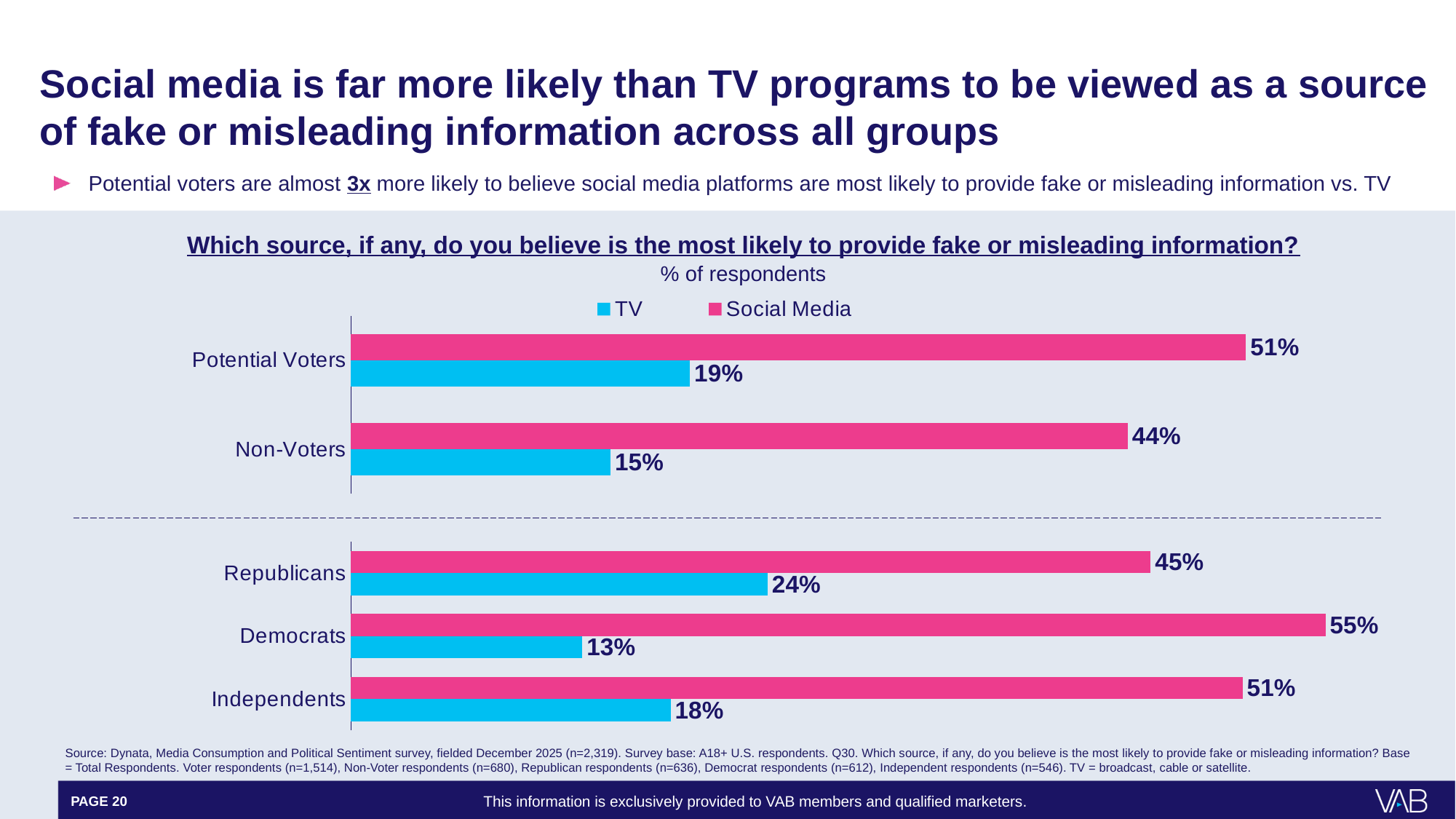
What is the Social Media value for Democrats? 55% Which is larger: the Social Media value for Republicans or for Non-Voters? Republicans What is the TV value for Non-Voters? 15% What is the difference between the TV values for Republicans and Independents? 6 percentage points What kind of chart is shown on the slide? Bar chart What is the TV value for Republicans? 24% Which group has the lowest TV value? Democrats Which group has the highest Social Media value? Democrats What is the difference between the Social Media and TV values for Potential Voters? 32 percentage points How many series does the legend list? 2 How many groups are shown on the chart? 5 What percentage of Potential Voters believe Social Media is the most likely source of fake or misleading information? 51%